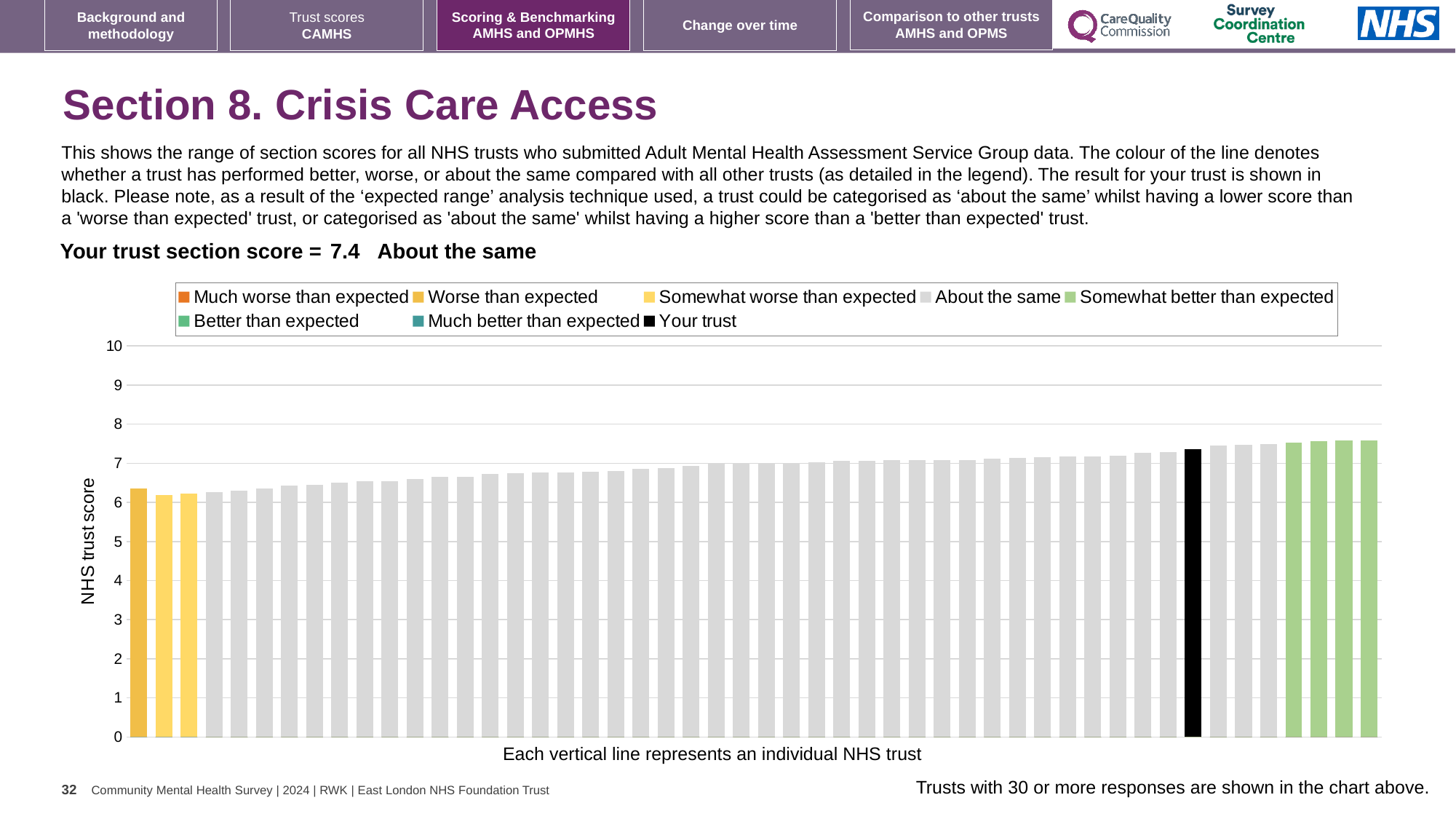
What kind of chart is shown on the slide? bar chart How many bars are coloured as 'Somewhat better than expected' (green)? 4 What is the section score for your trust, as printed on the slide? 7.4 What colour is used for the 'Your trust' bar in the chart? black Is the value for the lowest bar in the chart greater or less than 6? greater Are the values for the bars shown as 'Somewhat better than expected' greater or less than 7? greater Which is larger: the value for your trust (black bar) or the value for the leftmost bar? your trust How many entries does the chart legend list? 8 Is the value for your trust (the black bar) greater or less than 7? greater Do the bar values rise or fall from left to right along the x axis? rise What is the label on the vertical axis of the chart? NHS trust score